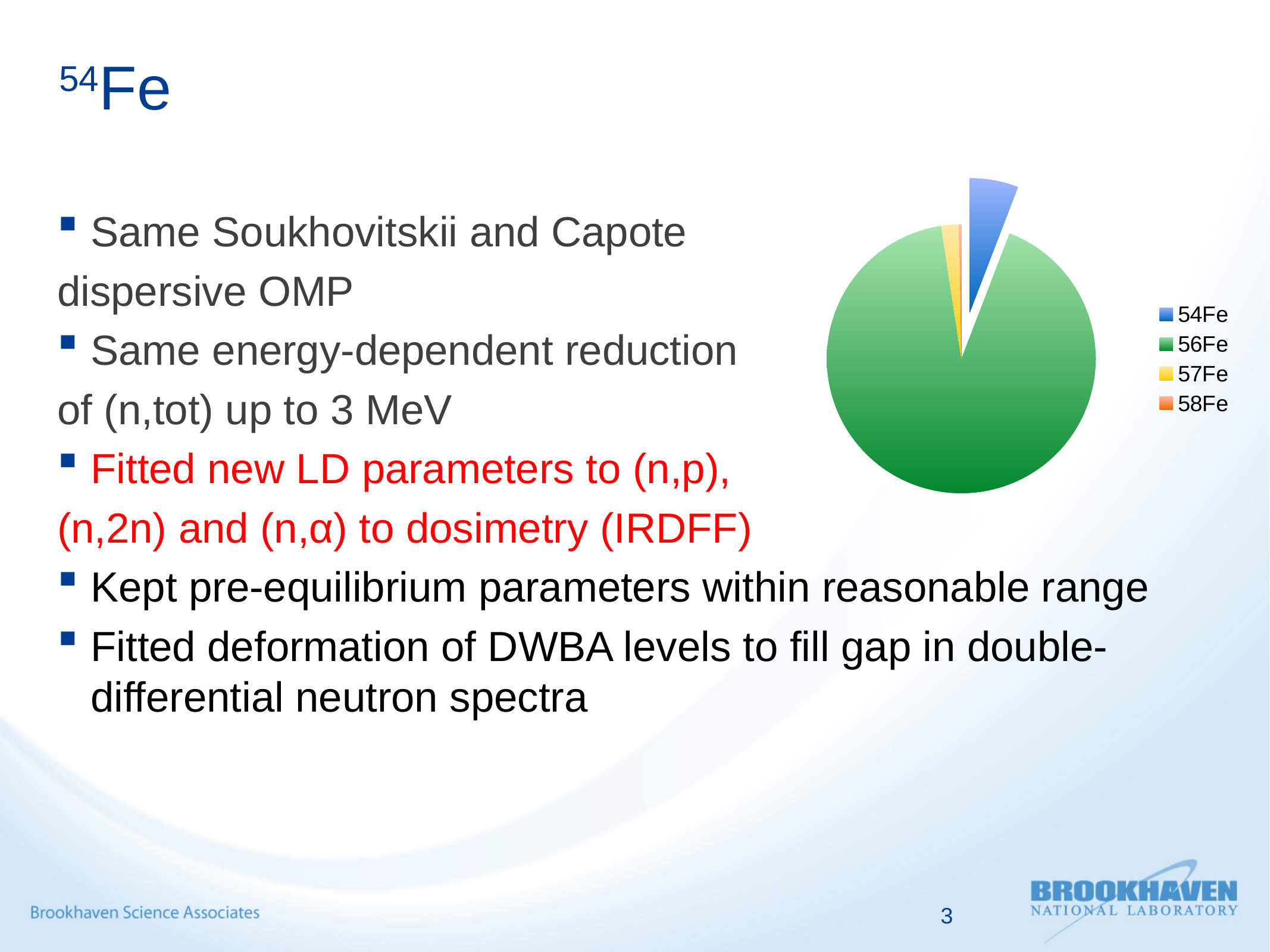
What colour is the 56Fe slice in the pie chart? green Which slice is pulled out (exploded) from the pie chart? 54Fe Which slice is larger in the pie chart, 54Fe or 57Fe? 54Fe What kind of chart is shown on the slide? pie chart How many entries does the legend of the pie chart list? 4 Which isotope has the smallest slice in the pie chart? 58Fe Which isotope has the largest slice in the pie chart? 56Fe How many slices does the pie chart have? 4 Which slice is larger in the pie chart, 57Fe or 58Fe? 57Fe Which slice is larger in the pie chart, 56Fe or 54Fe? 56Fe